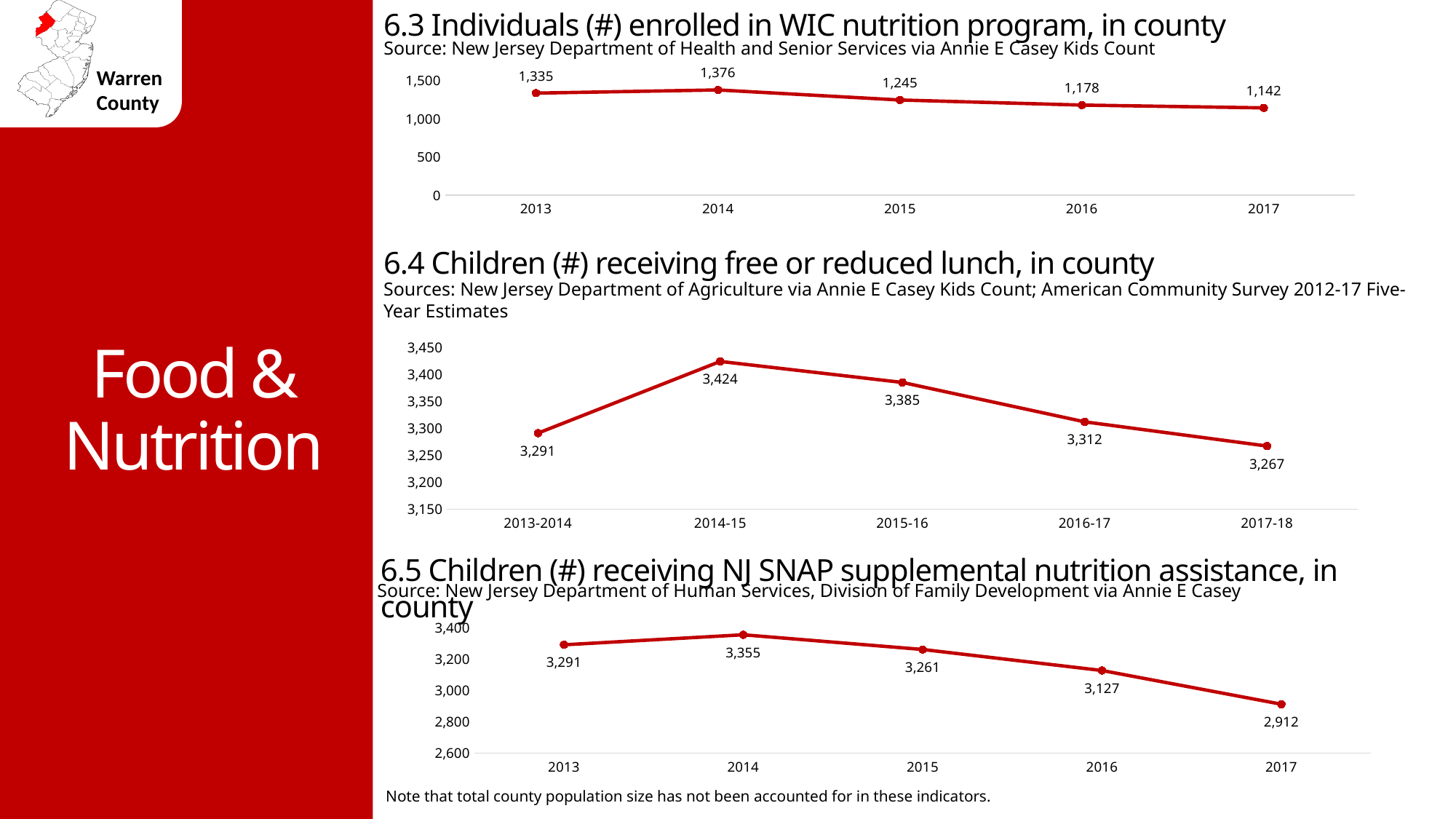
In the chart '6.4 Children (#) receiving free or reduced lunch, in county', what is the value for 2015-16? 3,385 What kind of chart is '6.5 Children (#) receiving NJ SNAP supplemental nutrition assistance, in county'? line chart In the chart '6.4 Children (#) receiving free or reduced lunch, in county', which is larger, the value for 2013-2014 or the value for 2017-18? 2013-2014 In the chart '6.4 Children (#) receiving free or reduced lunch, in county', what is the difference between the 2014-15 and 2016-17 values? 112 In the chart '6.4 Children (#) receiving free or reduced lunch, in county', which period has the highest value? 2014-15 In the chart '6.5 Children (#) receiving NJ SNAP supplemental nutrition assistance, in county', do the values rise or fall from 2014 to 2017? fall In the chart '6.5 Children (#) receiving NJ SNAP supplemental nutrition assistance, in county', what is the difference between the 2013 and 2017 values? 379 In the chart '6.3 Individuals (#) enrolled in WIC nutrition program, in county', how many years are plotted? 5 In the chart '6.5 Children (#) receiving NJ SNAP supplemental nutrition assistance, in county', what is the value for 2016? 3,127 In the chart '6.3 Individuals (#) enrolled in WIC nutrition program, in county', what is the value for 2014? 1,376 In the chart '6.3 Individuals (#) enrolled in WIC nutrition program, in county', which year has the lowest value? 2017 In the chart '6.3 Individuals (#) enrolled in WIC nutrition program, in county', what is the difference between the 2013 and 2017 values? 193